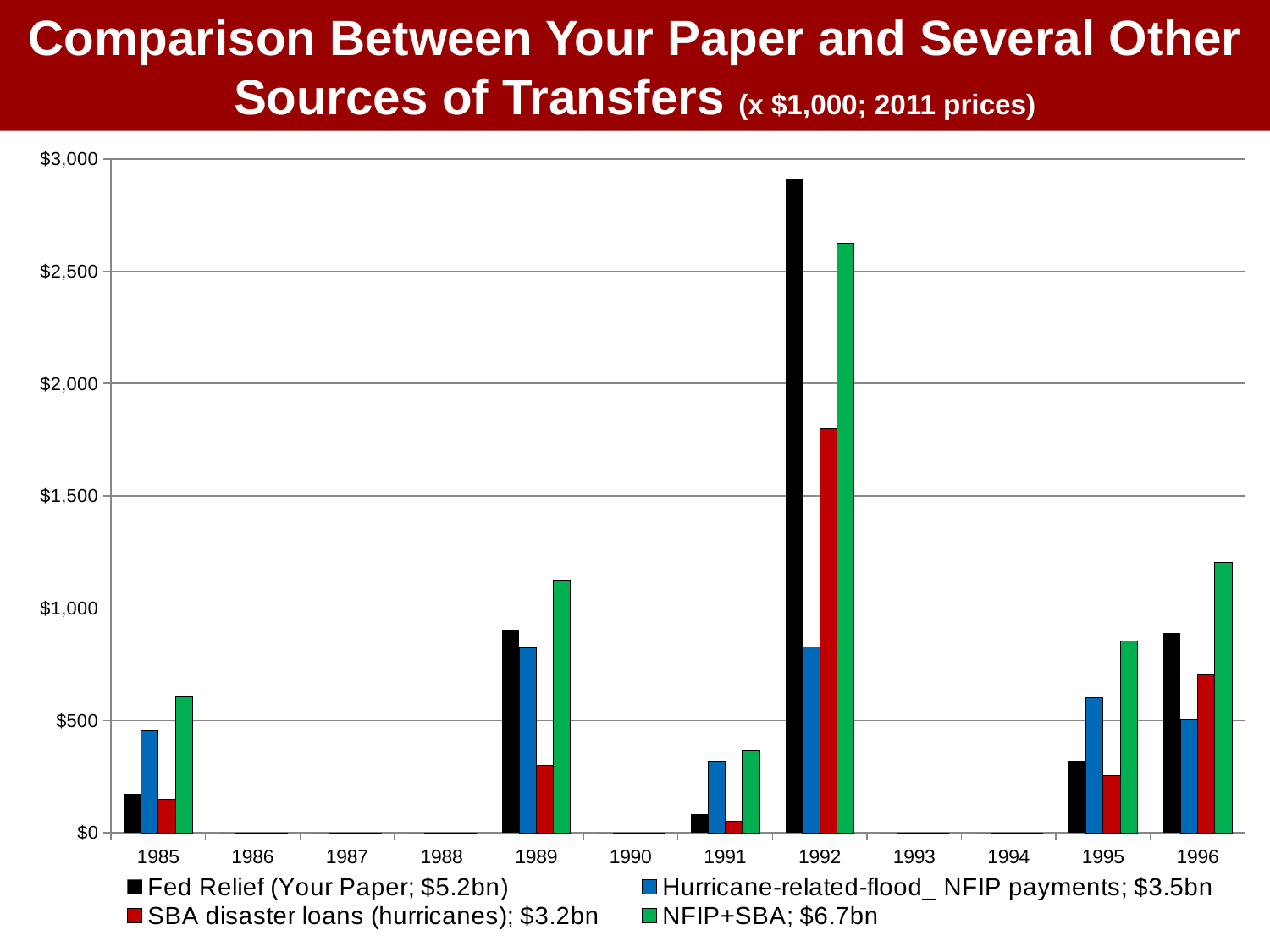
What kind of chart is shown on the slide? bar chart In which year is the NFIP+SBA value highest? 1992 Is the NFIP+SBA value for 1996 greater or less than $1,000? greater How many series does the legend list? 4 In 1995, which is larger: the Fed Relief (Your Paper) value or the NFIP+SBA value? NFIP+SBA Is the Fed Relief (Your Paper) value for 1992 greater or less than $2,500? greater What colour are the bars for the NFIP+SBA series? green How many years are shown on the x axis? 12 In 1992, which is larger: the SBA disaster loans (hurricanes) value or the Hurricane-related-flood NFIP payments value? SBA disaster loans (hurricanes) Is the Hurricane-related-flood NFIP payments value for 1985 greater or less than $500? less In which year is the Fed Relief (Your Paper) value highest? 1992